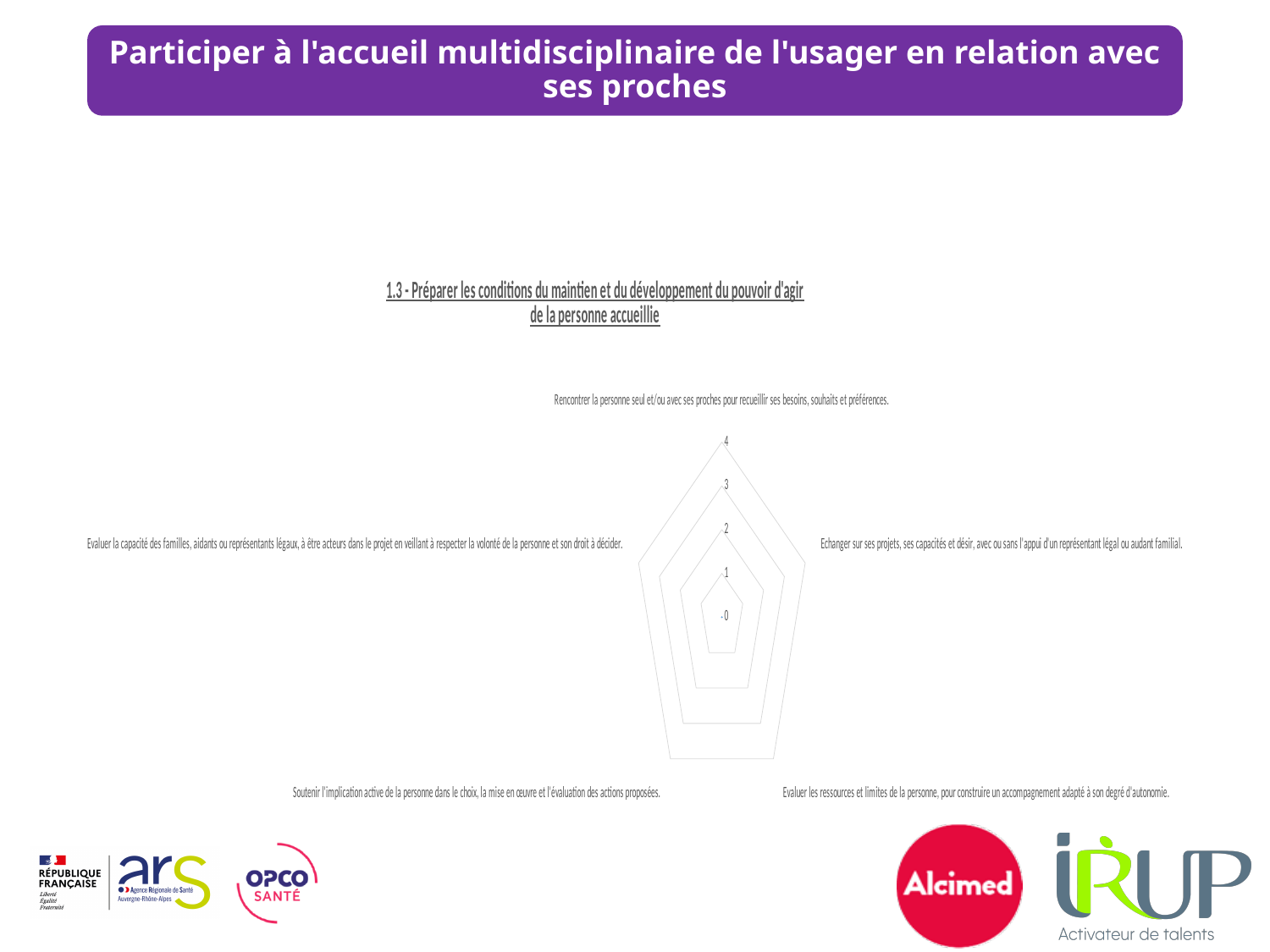
Which category label appears at the top of the radar chart? Rencontrer la personne seul et/ou avec ses proches pour recueillir ses besoins, souhaits et préférences. What is the highest value shown on the radar chart's scale? 4 How many categories (axes) does the radar chart have? 5 What is the title of the radar chart? 1.3 - Préparer les conditions du maintien et du développement du pouvoir d'agir de la personne accueillie What kind of chart is shown on the slide? radar chart